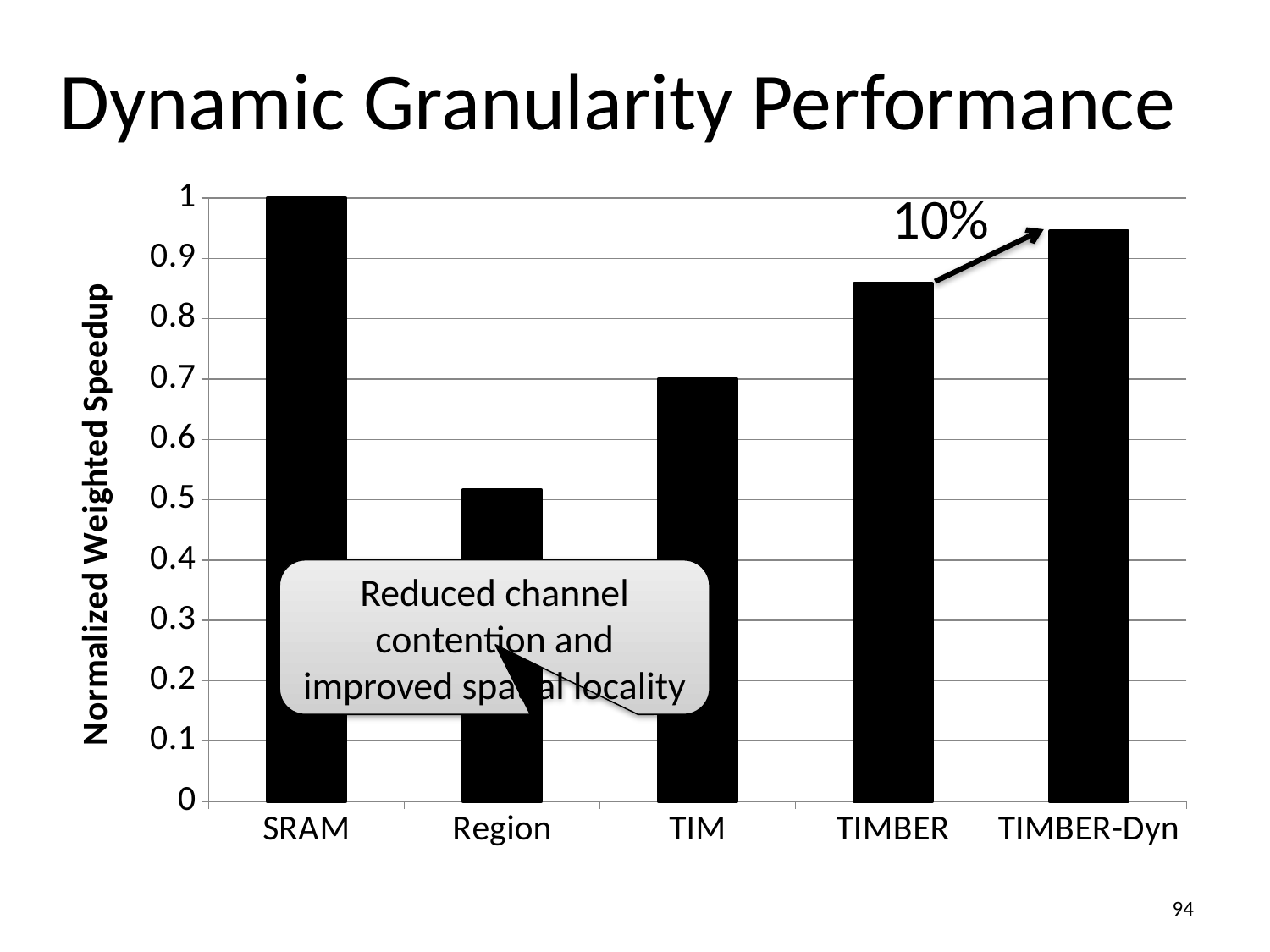
Is the value for TIMBER greater or less than 0.8? greater Which category has the lowest normalized weighted speedup? Region Which has a higher normalized weighted speedup, Region or TIM? TIM Is the value for TIMBER-Dyn greater or less than 0.9? greater Is the value for TIM greater or less than 0.6? greater What is the normalized weighted speedup for SRAM? 1 Which has a higher normalized weighted speedup, TIMBER or TIM? TIMBER What kind of chart is shown on the slide? bar chart How many categories are shown on the x axis of the chart? 5 Which category has the highest normalized weighted speedup? SRAM What is the label of the y axis? Normalized Weighted Speedup